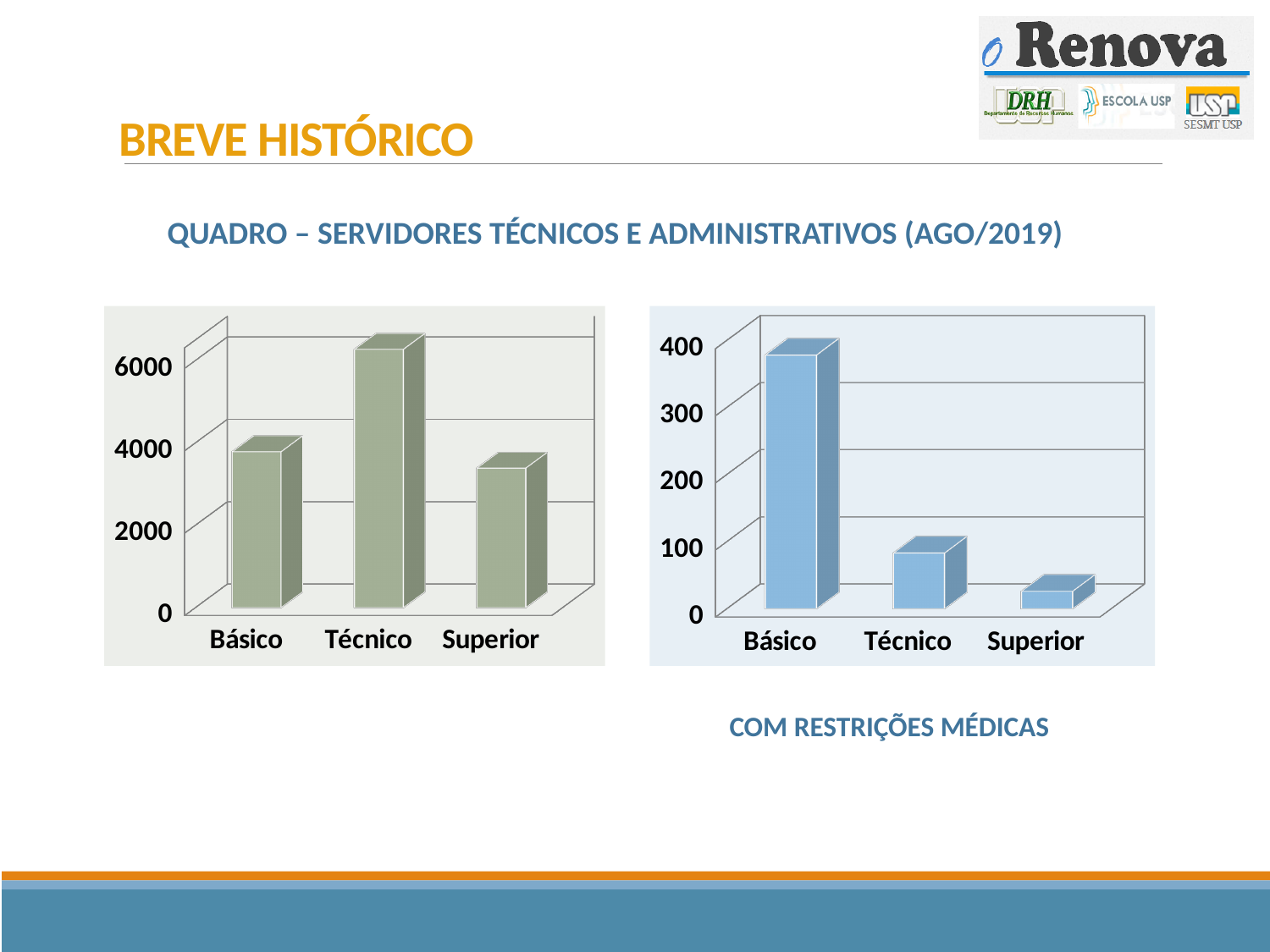
In the right chart (COM RESTRIÇÕES MÉDICAS), which category has the highest value? Básico What kind of chart is the left chart on the slide? bar chart In the right chart (COM RESTRIÇÕES MÉDICAS), which category has the lowest value? Superior In the left chart, which category has the highest value? Técnico In the right chart (COM RESTRIÇÕES MÉDICAS), is the value for Superior greater or less than 100? less How many categories are shown on the x axis of the left chart? 3 In the left chart, is the value for Técnico greater or less than 4000? greater In the right chart (COM RESTRIÇÕES MÉDICAS), is the value for Técnico greater or less than 200? less In the right chart (COM RESTRIÇÕES MÉDICAS), which is larger, the value for Básico or the value for Técnico? Básico What kind of chart is the right chart (COM RESTRIÇÕES MÉDICAS)? bar chart